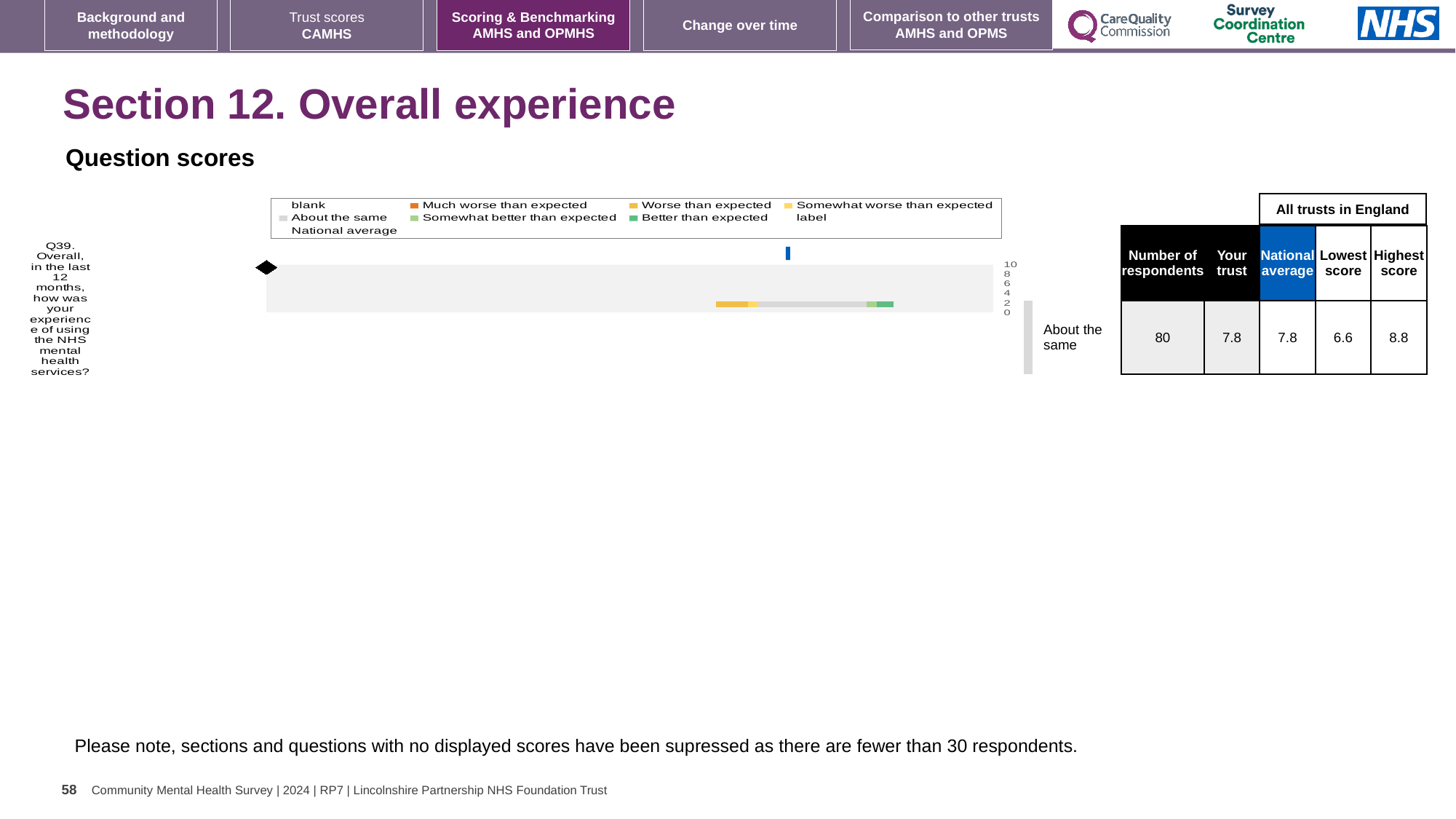
How many respondents answered Q39? 80 What is the highest score among all trusts in England for Q39? 8.8 What kind of chart is used to show the Q39 question score? bar chart How many questions are plotted in the question scores chart? 1 What is the 'Your trust' score for Q39 shown alongside the chart? 7.8 Is the national average marker for Q39 greater or less than 6 on the score axis? greater What is the national average score for Q39 shown alongside the chart? 7.8 What is the lowest score among all trusts in England for Q39? 6.6 What is the difference between the highest and lowest trust scores for Q39? 2.2 Is the national average marker for Q39 greater or less than 10 on the score axis? less What is the highest value shown on the chart's score axis? 10 Which benchmark category is Q39 assigned to in the chart? About the same